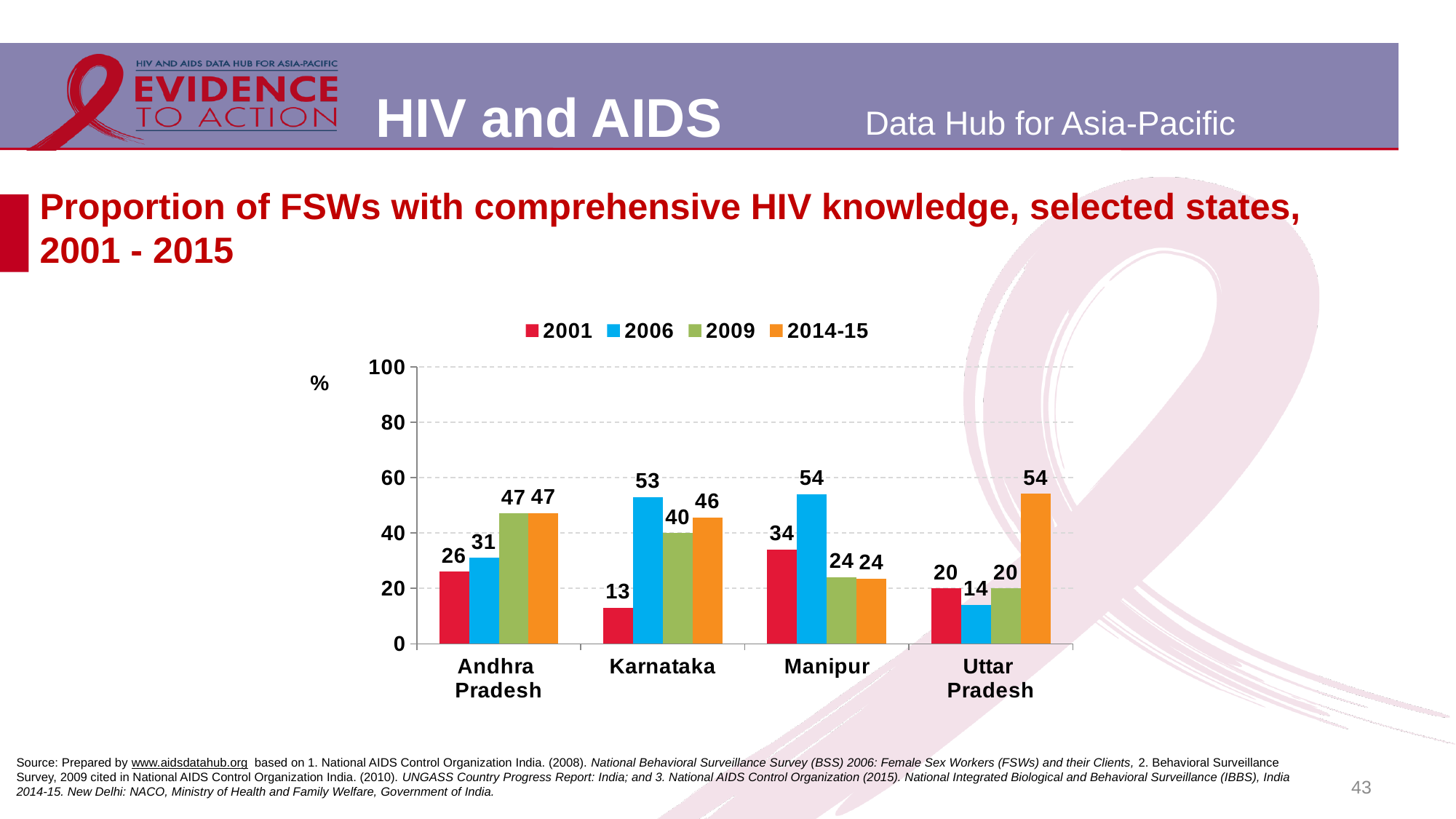
What is the value for Uttar Pradesh in 2014-15? 54 Which state has the lowest value in 2001? Karnataka Which state has the highest value in 2014-15? Uttar Pradesh Which is larger for Manipur: the 2006 value or the 2009 value? 2006 What is the value for Karnataka in 2006? 53 How many states are shown on the x axis? 4 How many series does the legend list? 4 What kind of chart is shown on the slide? bar chart What is the value for Manipur in 2001? 34 What is the difference between the 2006 and 2001 values for Karnataka? 40 Is the value for Andhra Pradesh in 2009 greater or less than 40? greater Which colour represents the 2014-15 series in the legend? orange